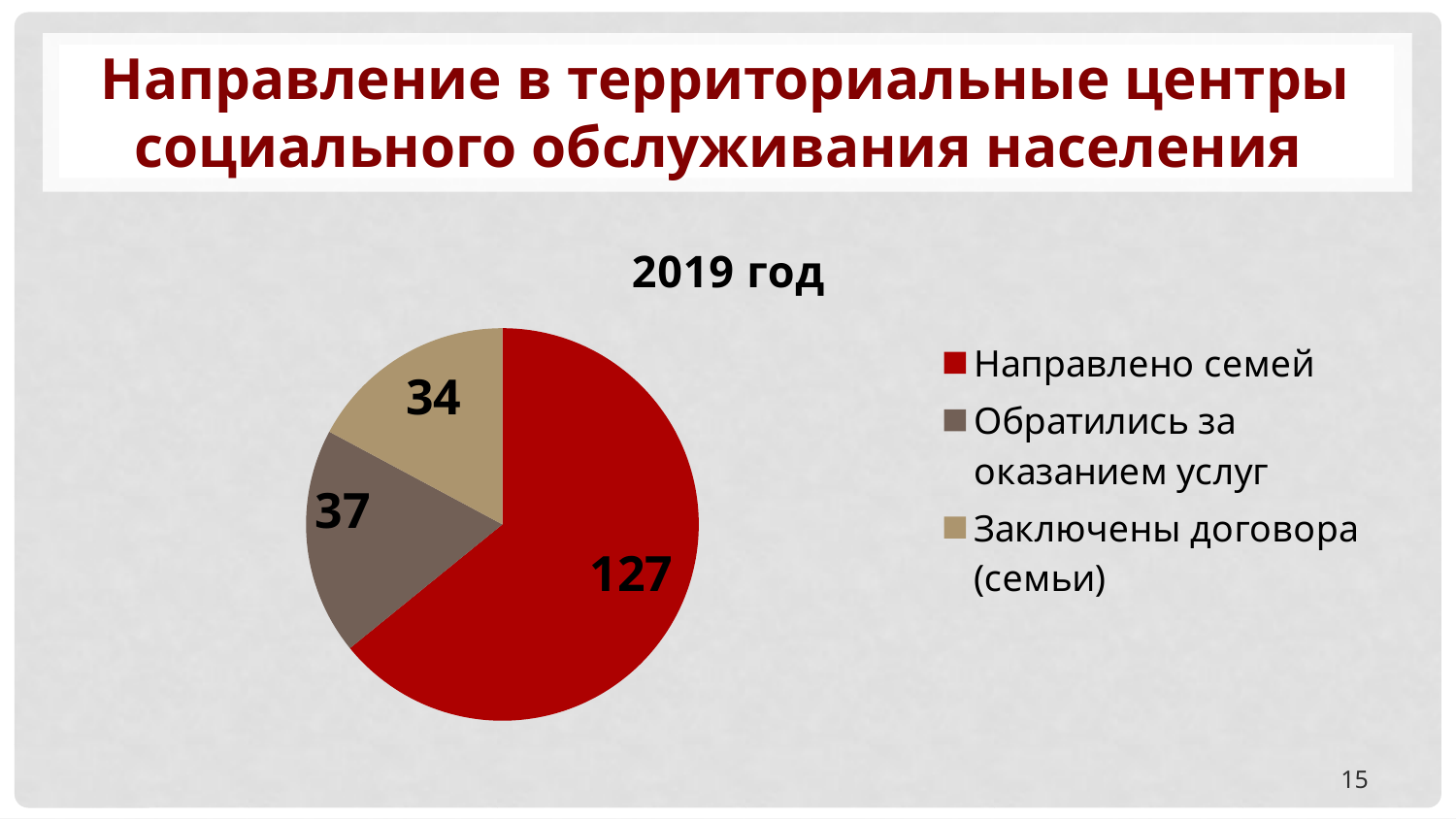
What is the difference between "Направлено семей" and "Обратились за оказанием услуг"? 90 What colour is the slice for "Направлено семей"? red What is the value for "Направлено семей"? 127 How many slices does the pie chart have? 3 What is the value for "Заключены договора (семьи)"? 34 What is the value for "Обратились за оказанием услуг"? 37 Which is larger: "Обратились за оказанием услуг" or "Заключены договора (семьи)"? Обратились за оказанием услуг Which category has the smallest slice? Заключены договора (семьи) What type of chart is shown on the slide? pie chart What is the title of the chart? 2019 год How many entries does the legend list? 3 Which category has the largest slice? Направлено семей